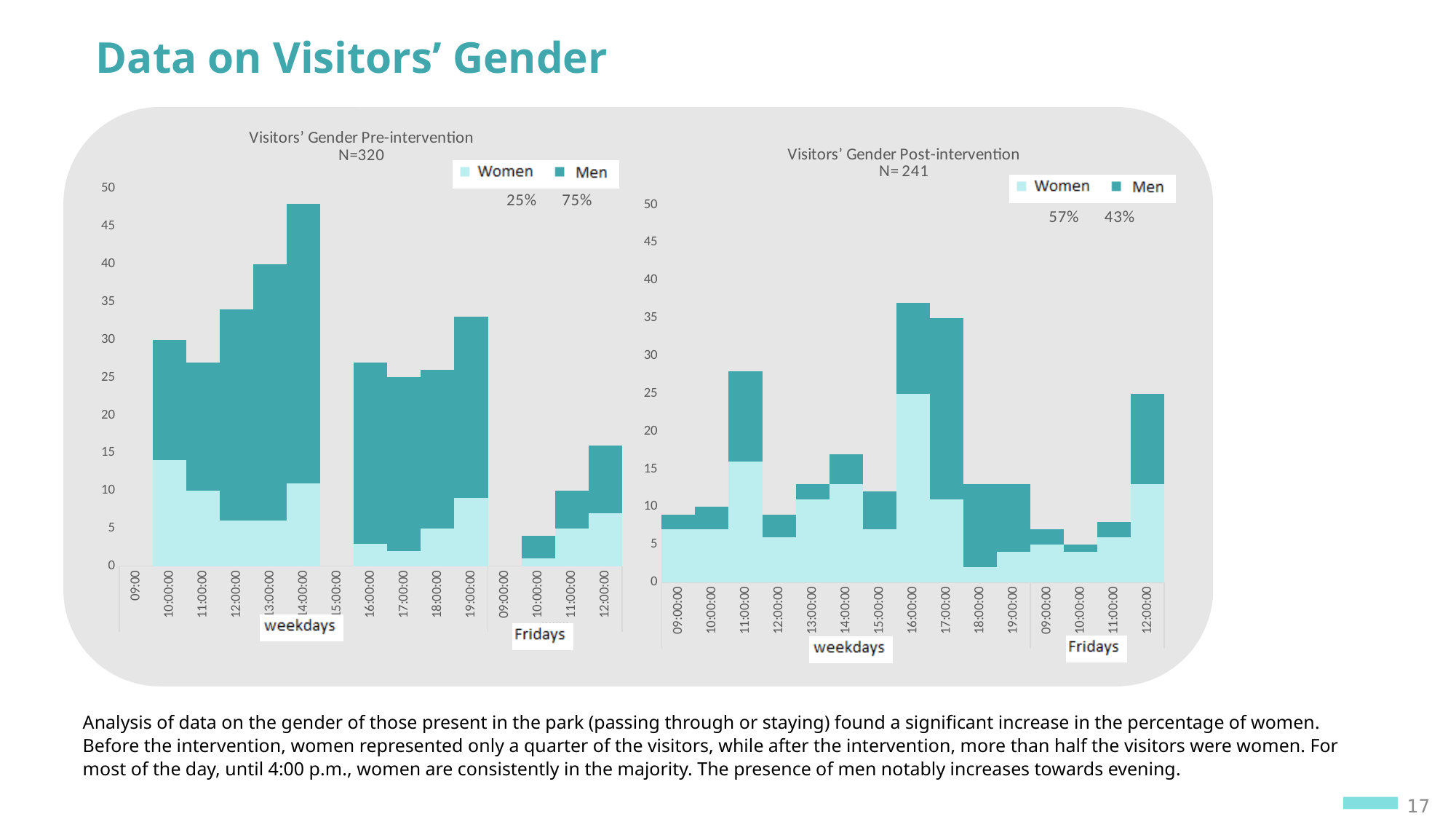
How many series does the legend list in the Visitors' Gender Pre-intervention chart? 2 How many Friday time slots are shown on the x axis of the Visitors' Gender Post-intervention chart? 4 What kind of chart is the Visitors' Gender Post-intervention chart? Stacked bar chart In the Visitors' Gender Pre-intervention chart, is the total for the 10:00:00 Friday bar greater or less than 5? less What percentage of visitors were men in the Visitors' Gender Post-intervention chart? 43% What is the sample size N shown for the Visitors' Gender Post-intervention chart? 241 In the Visitors' Gender Post-intervention chart, is the total for the 18:00:00 weekday bar greater or less than 15? less In the Visitors' Gender Pre-intervention chart, which weekday time slot has the highest total bar? 14:00:00 What percentage of visitors were women in the Visitors' Gender Pre-intervention chart? 25% In the Visitors' Gender Post-intervention chart, is the total for the 16:00:00 weekday bar greater or less than 35? greater In the Visitors' Gender Post-intervention chart, which Friday bar is taller, 09:00:00 or 12:00:00? 12:00:00